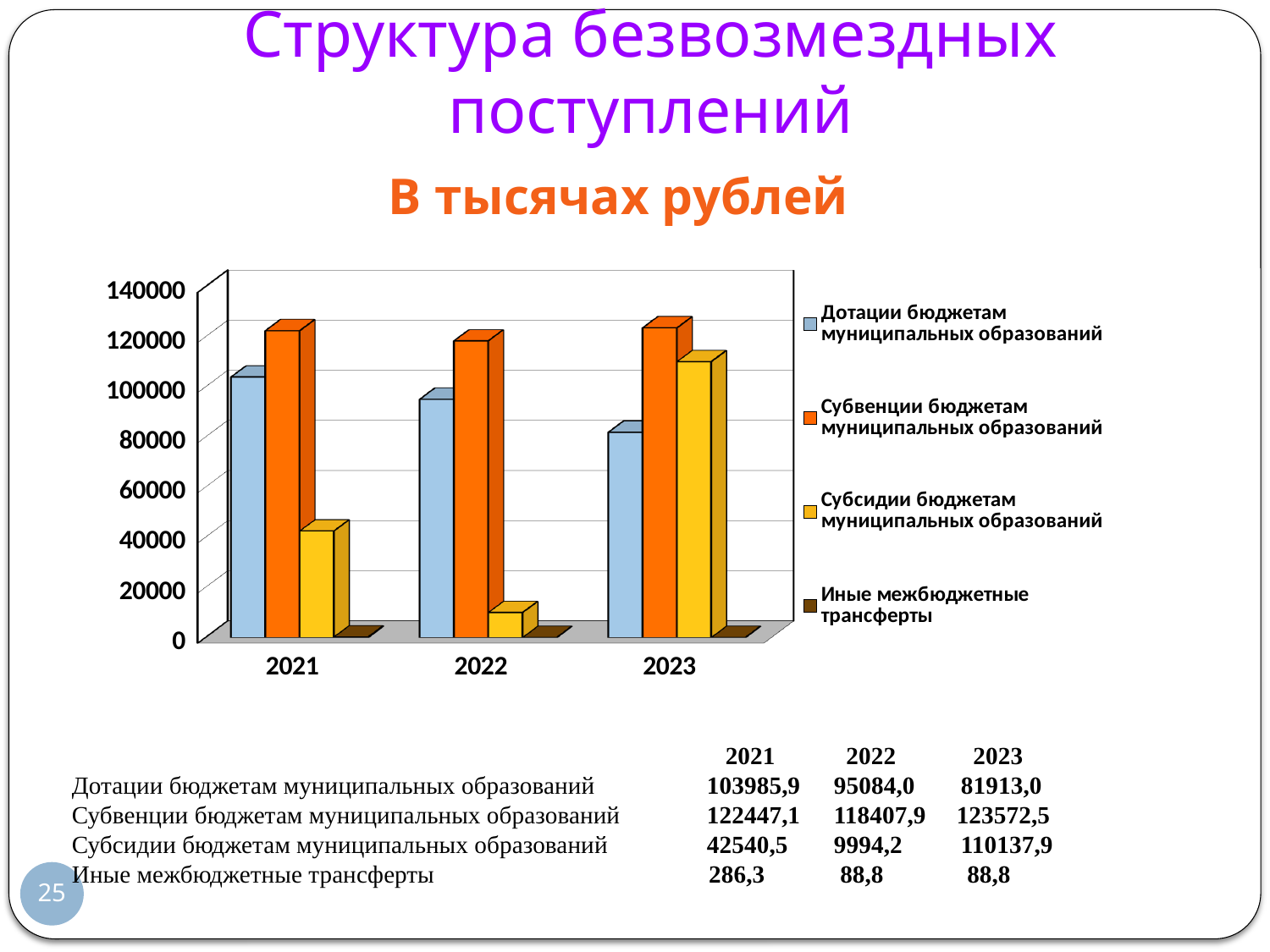
How many years are shown on the x axis of the chart? 3 What is the value of Субсидии бюджетам муниципальных образований in 2022? 9994,2 Which series has the lowest value in 2023? Иные межбюджетные трансферты Is the value of Субсидии бюджетам муниципальных образований larger in 2021 or in 2022? 2021 Do the values for Дотации бюджетам муниципальных образований rise or fall from 2021 to 2023? Fall What is the difference between Субвенции бюджетам муниципальных образований and Дотации бюджетам муниципальных образований in 2023? 41659,5 What colour represents Субсидии бюджетам муниципальных образований in the chart? Yellow Is the value for Дотации бюджетам муниципальных образований in 2021 greater or less than 100000? greater What is the value of Субвенции бюджетам муниципальных образований in 2023? 123572,5 What kind of chart is shown on the slide? Bar chart How many series does the chart legend list? 4 Which series has the highest value in 2021? Субвенции бюджетам муниципальных образований